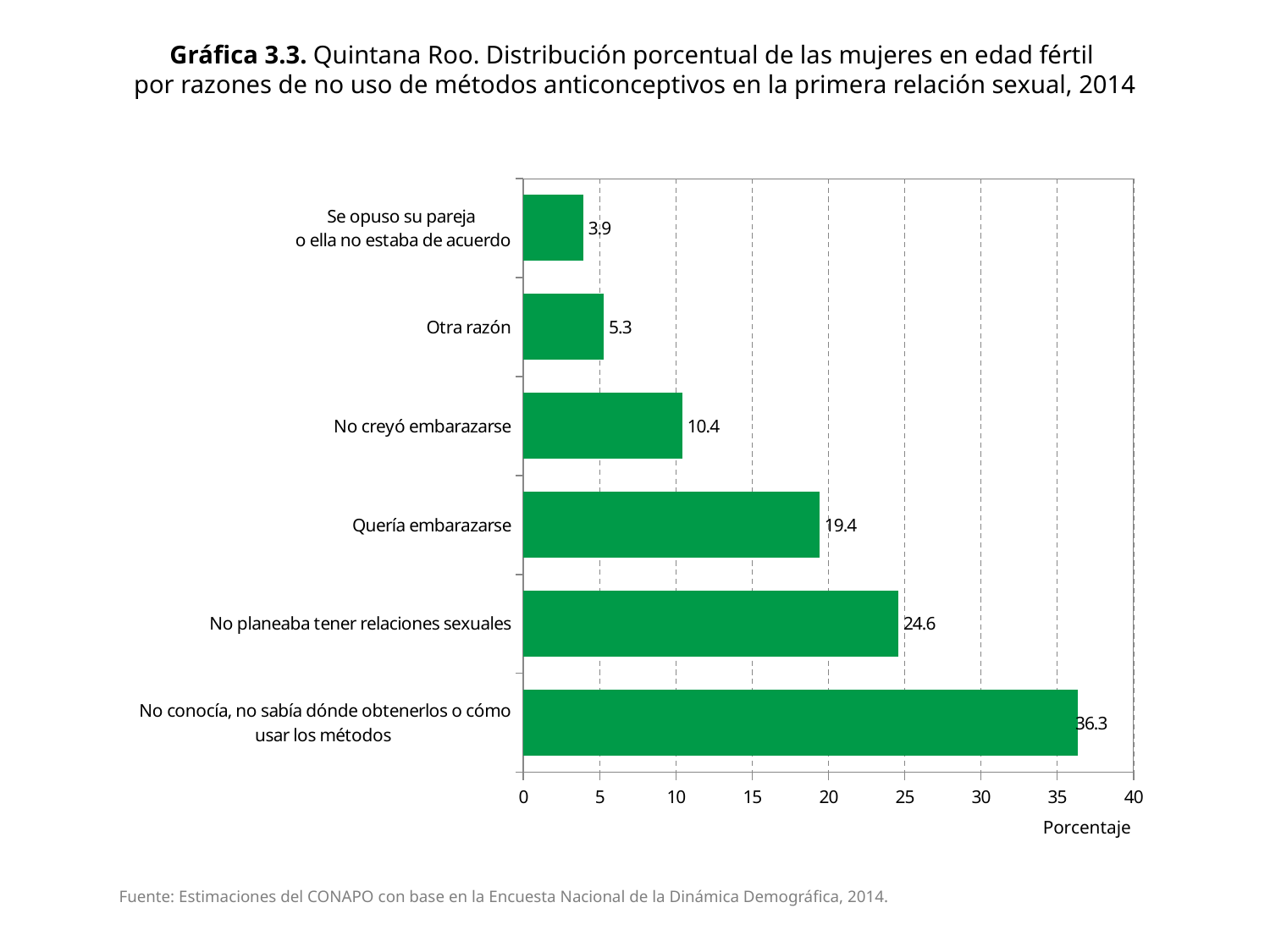
Which category has the lowest value? Se opuso su pareja o ella no estaba de acuerdo What is the value for "No planeaba tener relaciones sexuales"? 24.6 What is the value for "No creyó embarazarse"? 10.4 Which category has the highest value? No conocía, no sabía dónde obtenerlos o cómo usar los métodos What is the label of the horizontal axis? Porcentaje What is the maximum value shown on the horizontal axis? 40 How many categories are shown in the chart? 6 What is the difference between the values for "No planeaba tener relaciones sexuales" and "Quería embarazarse"? 5.2 Which is larger, the value for "Quería embarazarse" or the value for "No creyó embarazarse"? Quería embarazarse What kind of chart is shown on the slide? bar chart Is the value for "No conocía, no sabía dónde obtenerlos o cómo usar los métodos" greater or less than 35? greater What is the value for "Otra razón"? 5.3